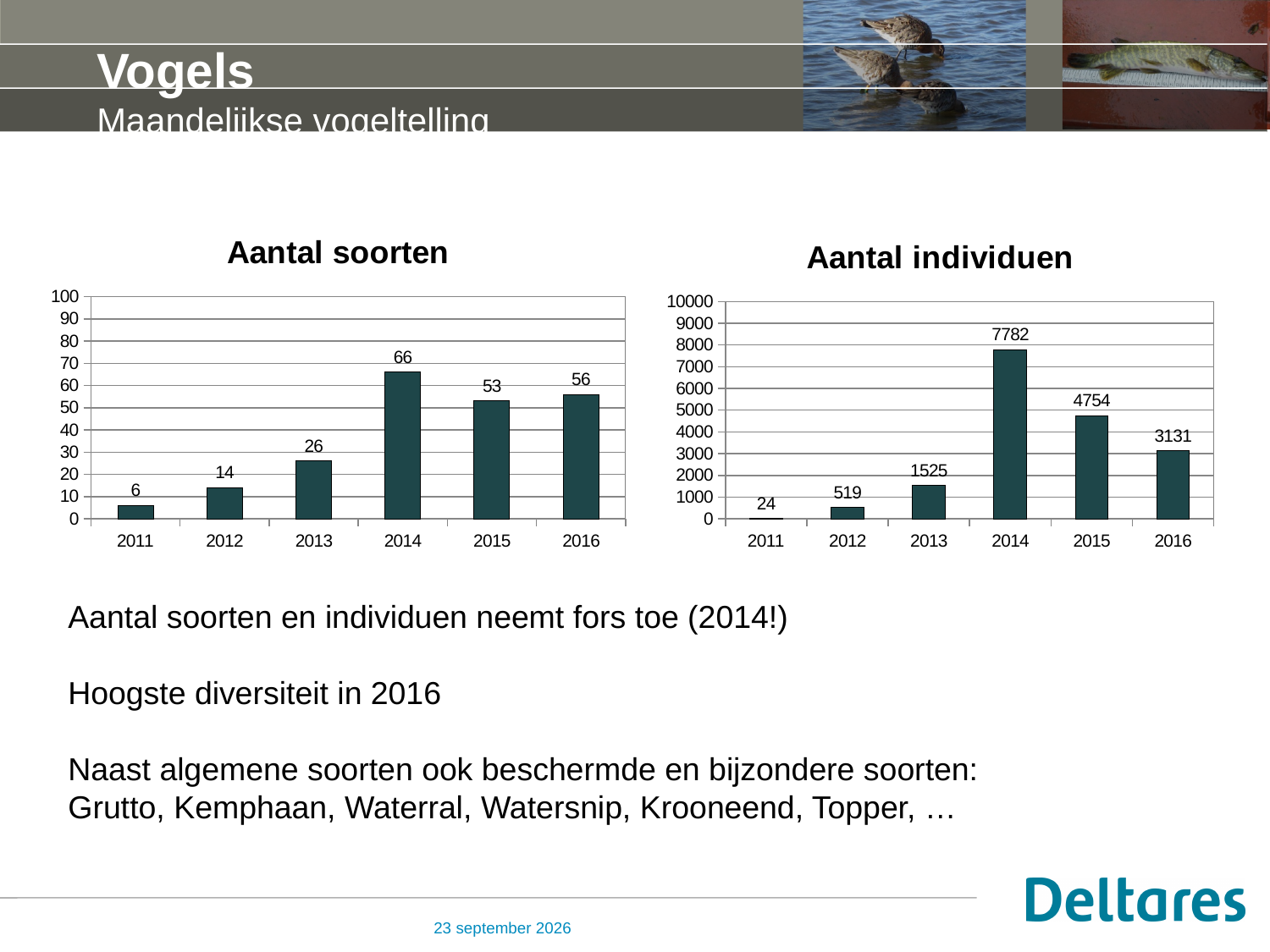
In the 'Aantal soorten' chart, what is the value for 2014? 66 What is the title of the chart on the right side of the slide? Aantal individuen What kind of chart is the 'Aantal individuen' chart? bar chart In the 'Aantal individuen' chart, what is the difference between the values for 2015 and 2016? 1623 In the 'Aantal soorten' chart, do the values rise or fall from 2011 to 2014? rise How many years are shown on the x axis of the 'Aantal soorten' chart? 6 In the 'Aantal soorten' chart, which year has the lowest value? 2011 In the 'Aantal individuen' chart, which year has the highest value? 2014 In the 'Aantal soorten' chart, what is the difference between the values for 2014 and 2013? 40 In the 'Aantal individuen' chart, is the value for 2013 greater or less than 2000? less In the 'Aantal individuen' chart, what is the value for 2015? 4754 In the 'Aantal soorten' chart, which is larger, the value for 2015 or the value for 2016? 2016